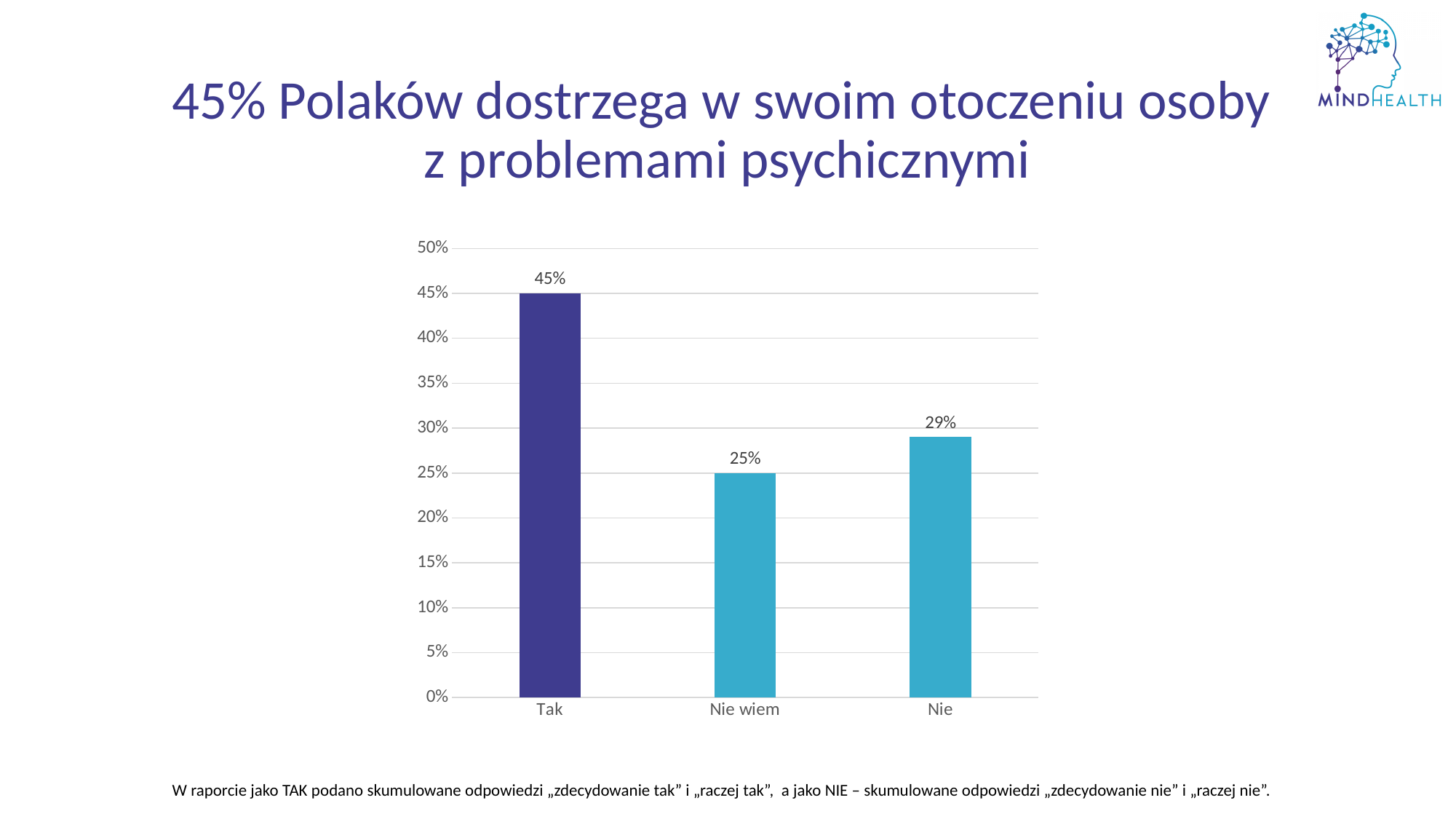
What is the value for "Nie wiem"? 25% What is the value for "Tak"? 45% What kind of chart is shown on the slide? bar chart What is the difference between the values for "Tak" and "Nie"? 16% Is the value for "Nie" greater or less than 30%? less Which bar is shown in a different colour from the other two? Tak Which is larger, the value for "Nie" or the value for "Nie wiem"? Nie What is the difference between the values for "Nie" and "Nie wiem"? 4% Which category has the lowest value? Nie wiem What is the value for "Nie"? 29% How many categories are shown on the x axis? 3 Which category has the highest value? Tak